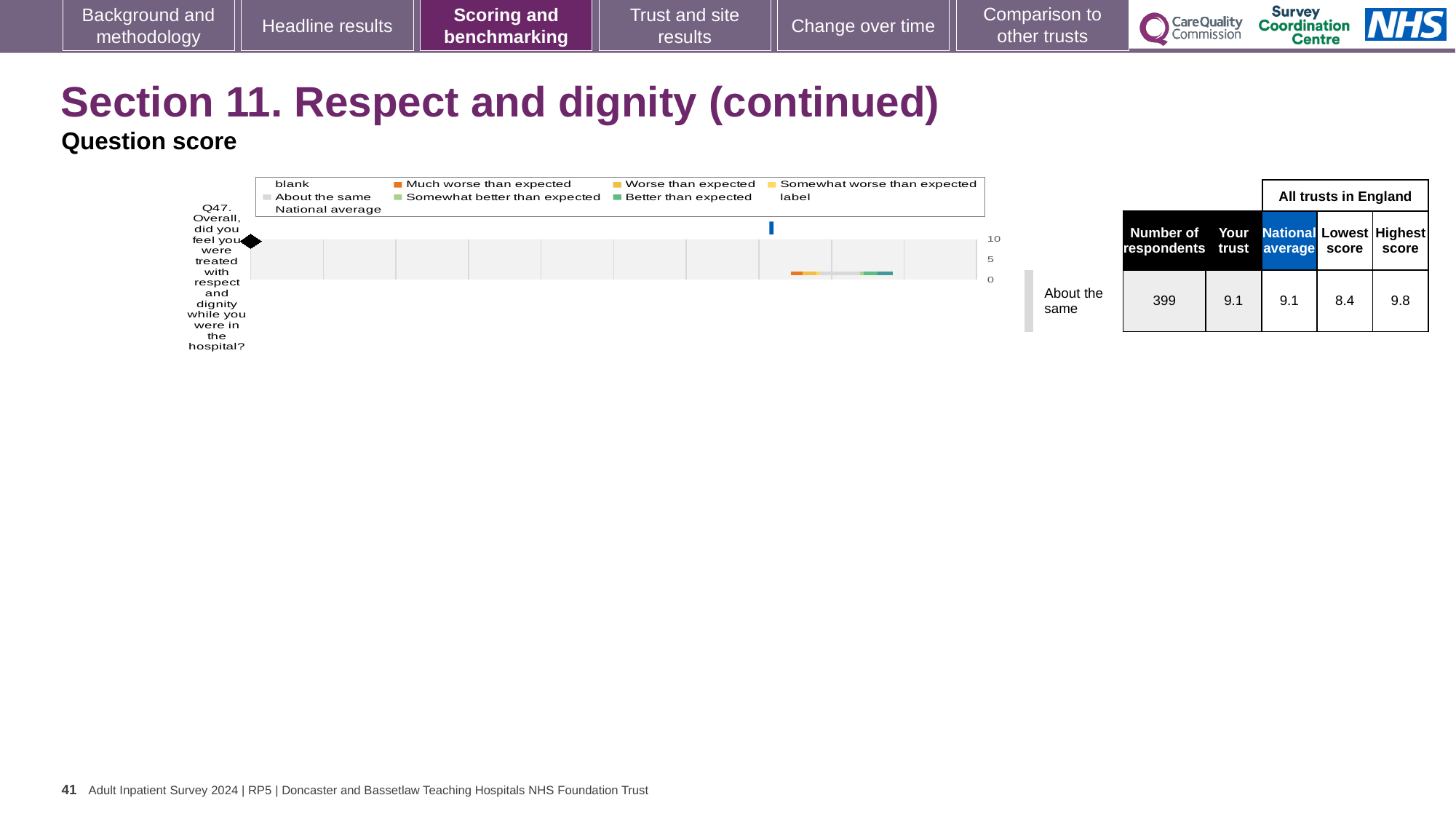
What is the highest score among all trusts in England for Q47? 9.8 How many respondents answered Q47? 399 What is the lowest score among all trusts in England for Q47? 8.4 How many questions are plotted on the chart? 1 What is the difference between the highest score and the lowest score for Q47? 1.4 Is the trust's score for Q47 higher than, lower than, or the same as the national average? the same What is the 'Your trust' score for Q47? 9.1 Which benchmarking category is the trust's Q47 result labelled as? About the same What kind of chart is used to show the Q47 question score? bar chart What is the highest tick value shown on the chart's axis? 10 What is the national average score for Q47? 9.1 Is the trust's score for Q47 greater or less than 5? greater